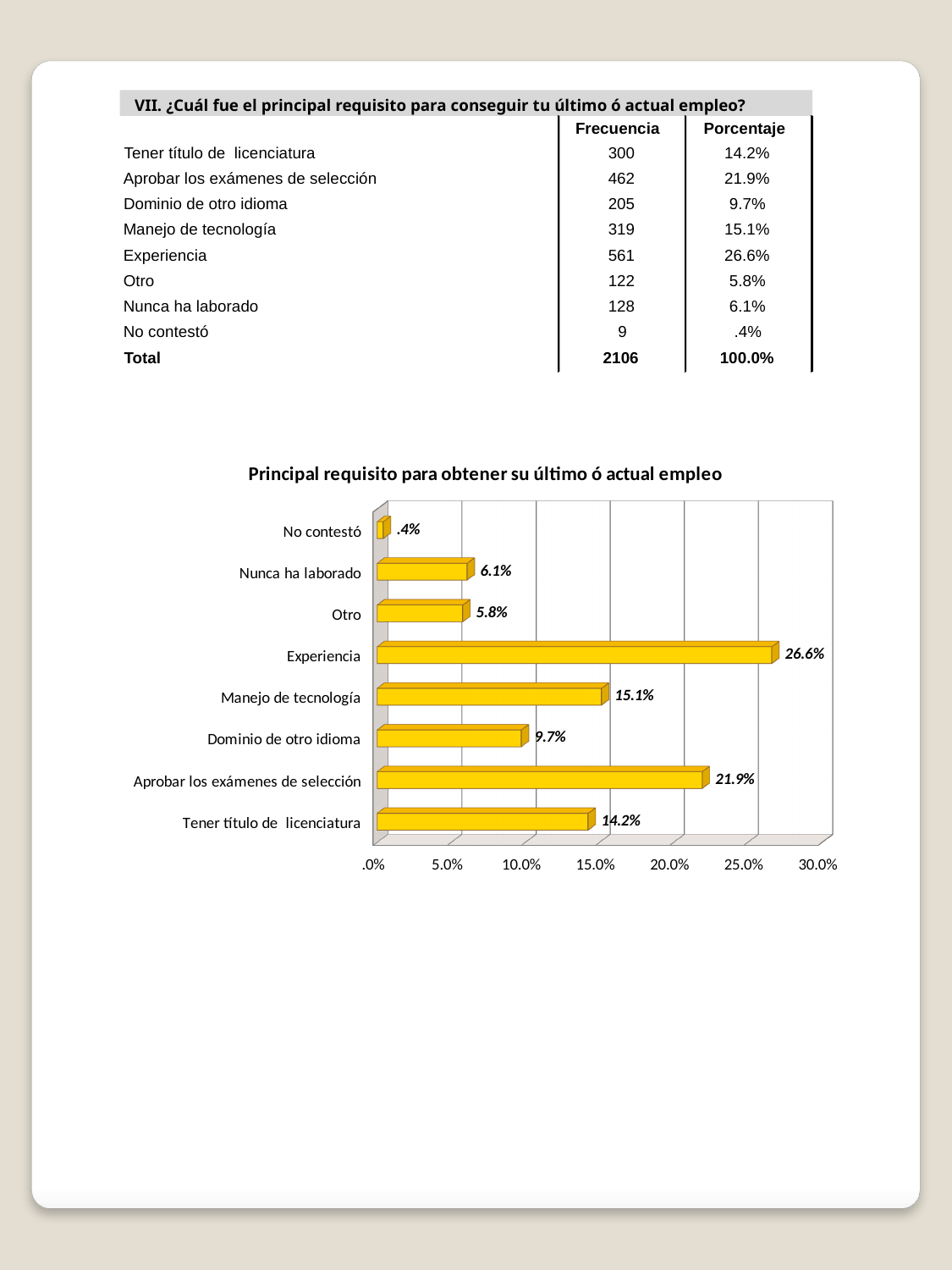
What is the difference between the values for Experiencia and Aprobar los exámenes de selección? 4.7% Which is larger, the value for Nunca ha laborado or the value for Otro? Nunca ha laborado What is the title of the chart? Principal requisito para obtener su último ó actual empleo What is the value for Dominio de otro idioma in the chart? 9.7% What is the difference between the values for Manejo de tecnología and Tener título de licenciatura? 0.9% How many categories are shown in the chart? 8 Is the value for Manejo de tecnología greater or less than 15.0%? greater Which category has the highest value in the chart? Experiencia Which category has the lowest value in the chart? No contestó What is the value for Aprobar los exámenes de selección in the chart? 21.9% What kind of chart is shown on the slide? bar chart What is the value for Experiencia in the chart? 26.6%